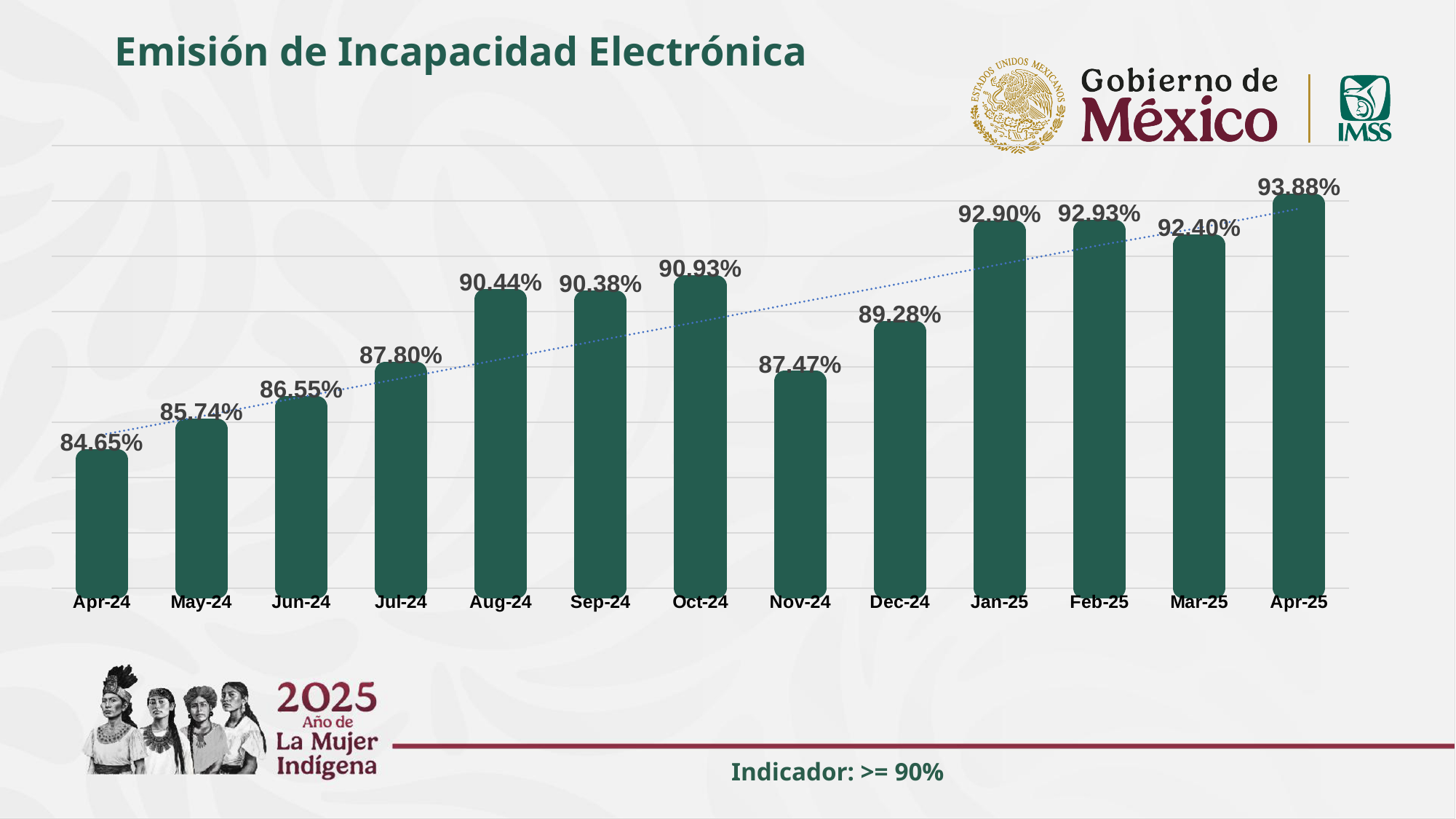
What is the value for Jan-25? 92.90% Which month has the highest value? Apr-25 What is the value for Apr-24? 84.65% What kind of chart is shown on the slide? Bar chart What is the difference between the values for Apr-25 and Apr-24? 9.23 percentage points How many months are shown on the x axis? 13 What is the value for Oct-24? 90.93% Which is larger, the value for Oct-24 or the value for Nov-24? Oct-24 Which month has the lowest value? Apr-24 What is the title of the chart? Emisión de Incapacidad Electrónica What is the value for Nov-24? 87.47% Do the values generally rise or fall from Apr-24 to Apr-25? Rise